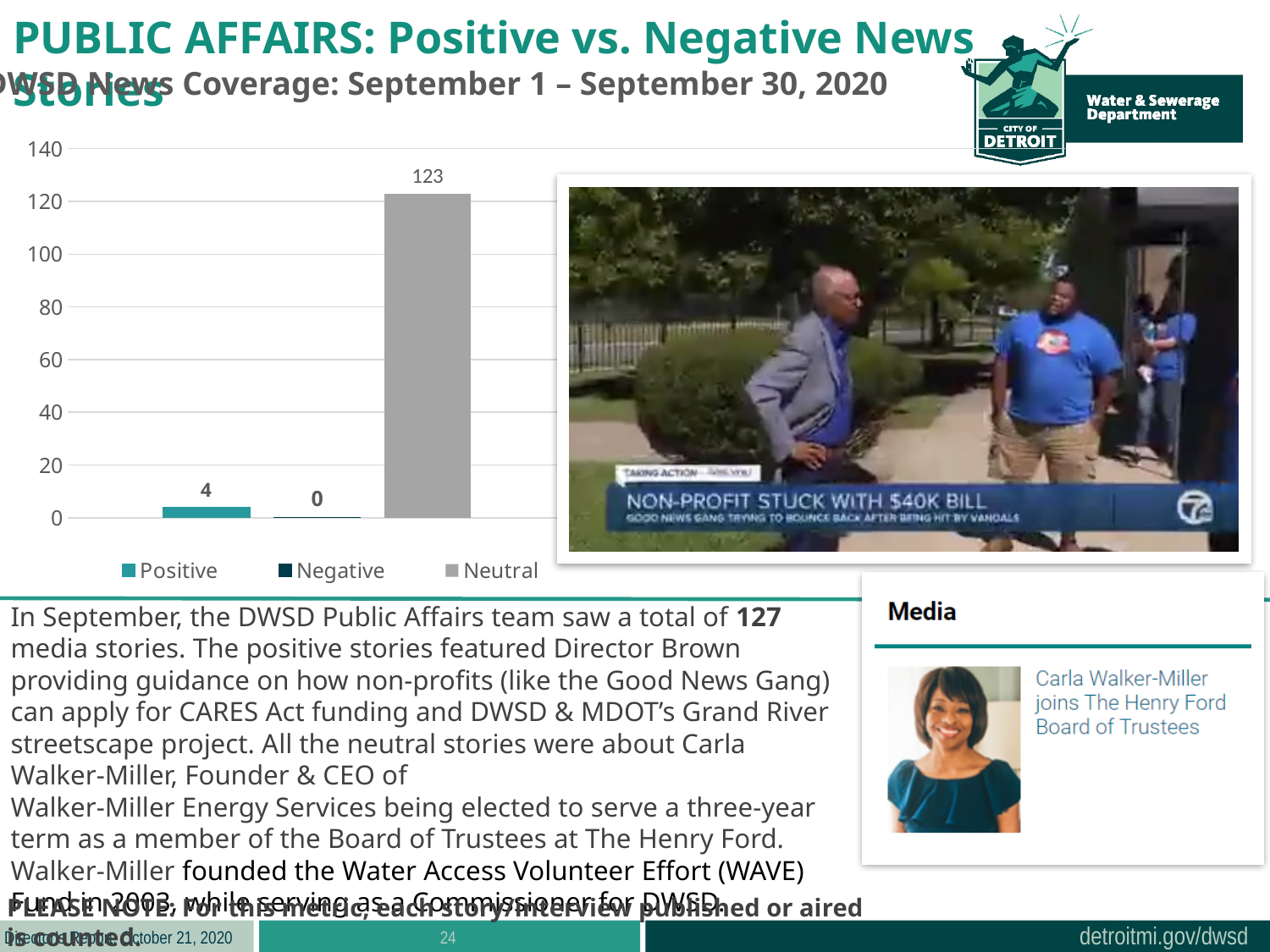
What is the difference between the Neutral and Positive values in the bar chart? 119 What is the total of the three values plotted in the bar chart? 127 Which category has the highest value in the bar chart? Neutral What is the value for Positive in the bar chart? 4 What is the highest value shown on the vertical axis of the bar chart? 140 What kind of chart is shown on the slide? Bar chart Which category has the lowest value in the bar chart? Negative Which is larger in the bar chart, Positive or Negative? Positive How many series does the legend of the bar chart list? 3 What is the value for Negative in the bar chart? 0 Is the value for Neutral greater or less than 100? greater What is the value for Neutral in the bar chart? 123